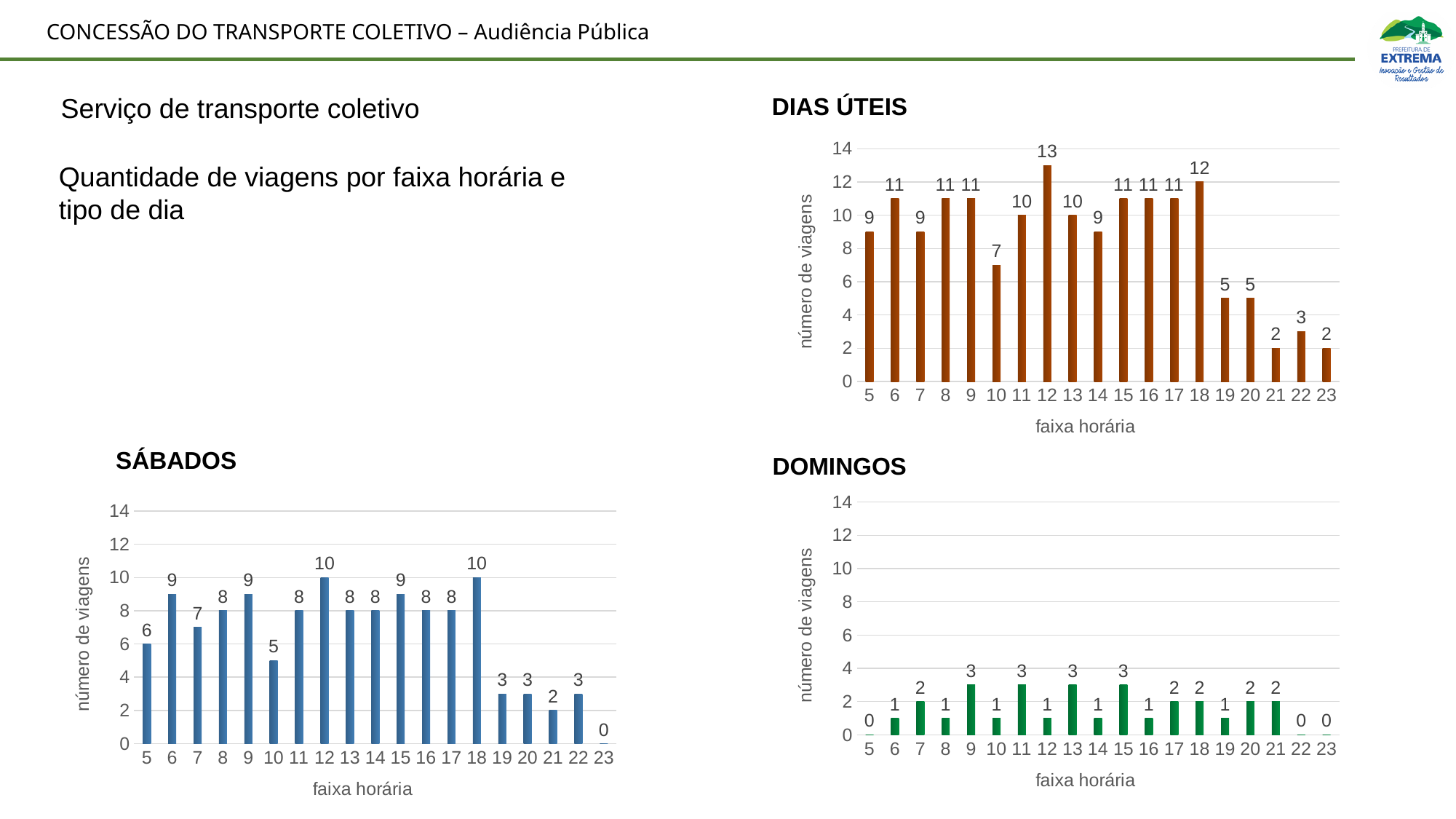
In the DIAS ÚTEIS chart, how many viagens are there in the 12 faixa horária? 13 In the SÁBADOS chart, which is larger, the value for faixa horária 6 or faixa horária 7? 6 What type of chart is the DOMINGOS chart? bar chart In the SÁBADOS chart, how many viagens are there in the 10 faixa horária? 5 What is the y-axis label of the DIAS ÚTEIS chart? número de viagens In the SÁBADOS chart, what is the difference between the values for faixa horária 12 and faixa horária 5? 4 In the SÁBADOS chart, which faixa horária has the lowest número de viagens? 23 In the DIAS ÚTEIS chart, which faixa horária has the highest número de viagens? 12 In the DOMINGOS chart, how many viagens are there in the 9 faixa horária? 3 In the DIAS ÚTEIS chart, how many faixas horárias are shown on the x axis? 19 In the DIAS ÚTEIS chart, what is the difference between the values for faixa horária 18 and faixa horária 19? 7 In the DOMINGOS chart, which is larger, the value for faixa horária 17 or faixa horária 19? 17